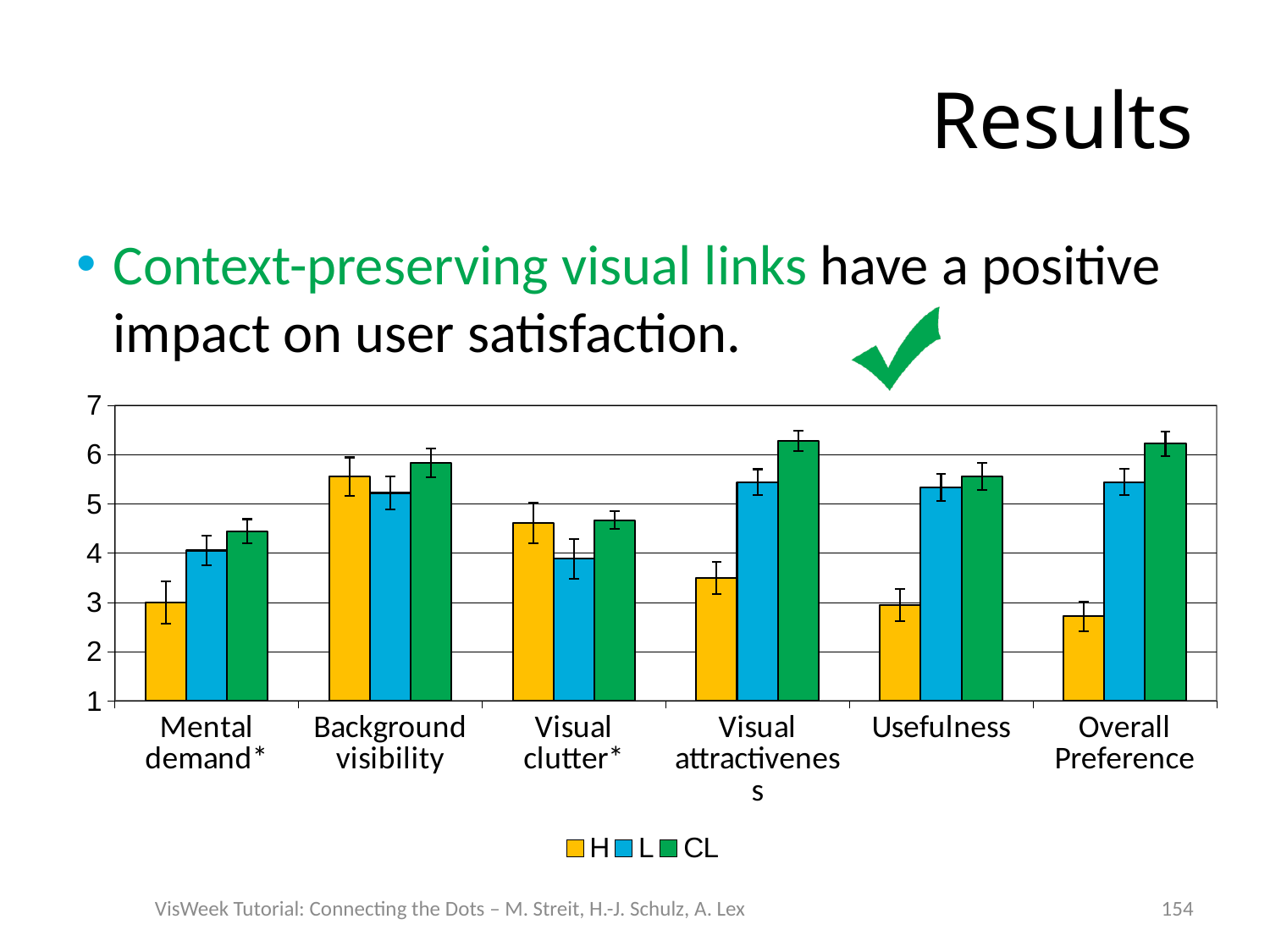
Is the value for H in Mental demand* greater or less than 4? less For Overall Preference, which is larger: the value for CL or the value for H? CL For Visual clutter*, which is larger: the value for H or the value for L? H Which series has the lowest value in the Usefulness category? H What kind of chart is shown on the slide? bar chart What are the entries in the chart's legend? H, L, CL How many series does the chart's legend list? 3 Which series has the highest value in the Visual attractiveness category? CL In which category does the H series reach its highest value? Background visibility How many categories are shown along the x axis of the chart? 6 Is the value for L in Overall Preference greater or less than 5? greater Is the value for CL in Visual attractiveness greater or less than 6? greater